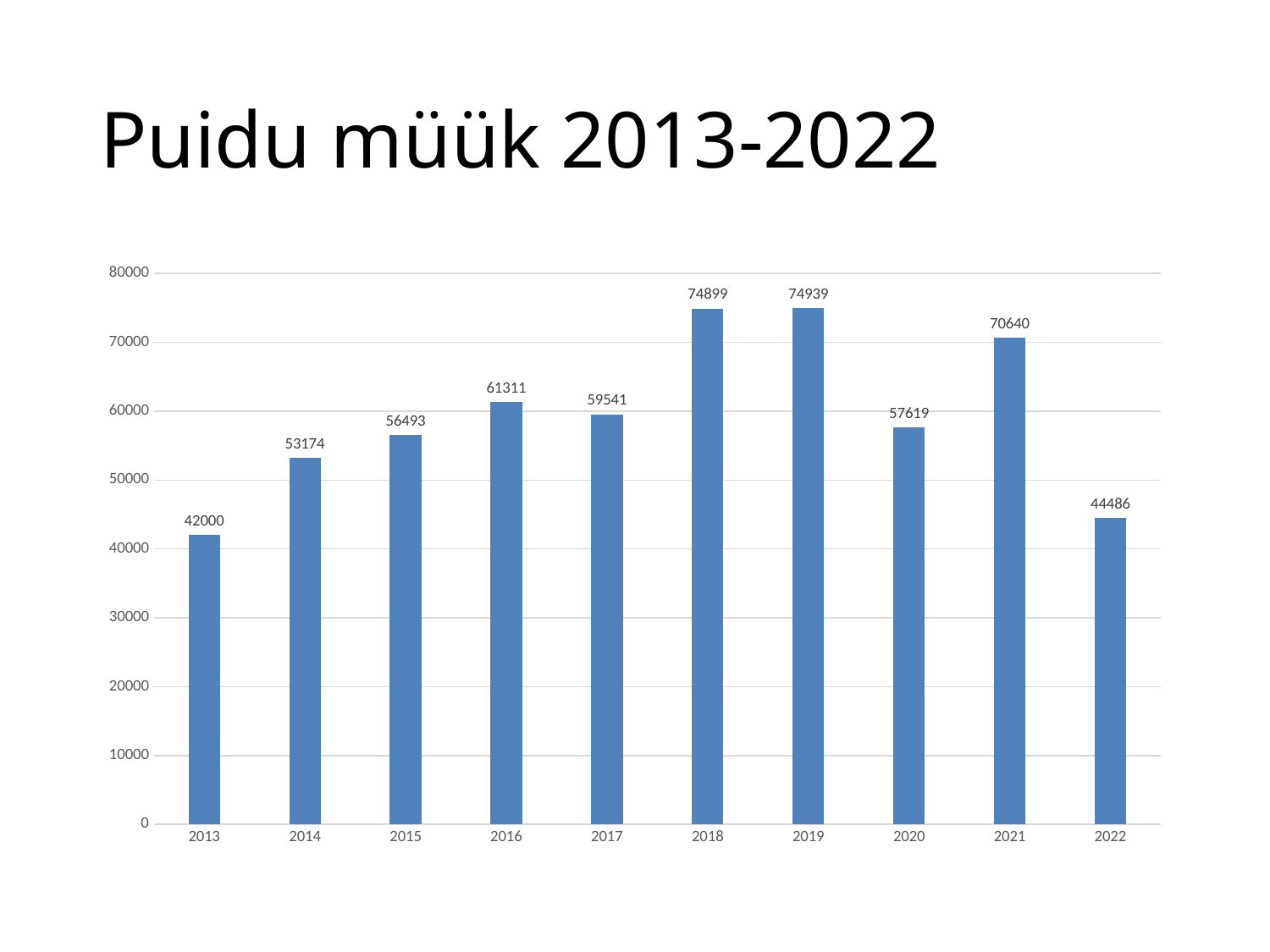
Is the value for 2020 greater or less than 50000? greater How many years are shown on the x axis? 10 Do the values rise or fall from 2013 to 2016? rise Which year has the highest value? 2019 Which is larger, the value for 2017 or the value for 2020? 2017 What kind of chart is shown on the slide? bar chart What is the value for 2018? 74899 Which year has the lowest value? 2013 What is the difference between the values for 2021 and 2022? 26154 What is the value for 2022? 44486 What is the difference between the values for 2018 and 2013? 32899 What is the value for 2013? 42000